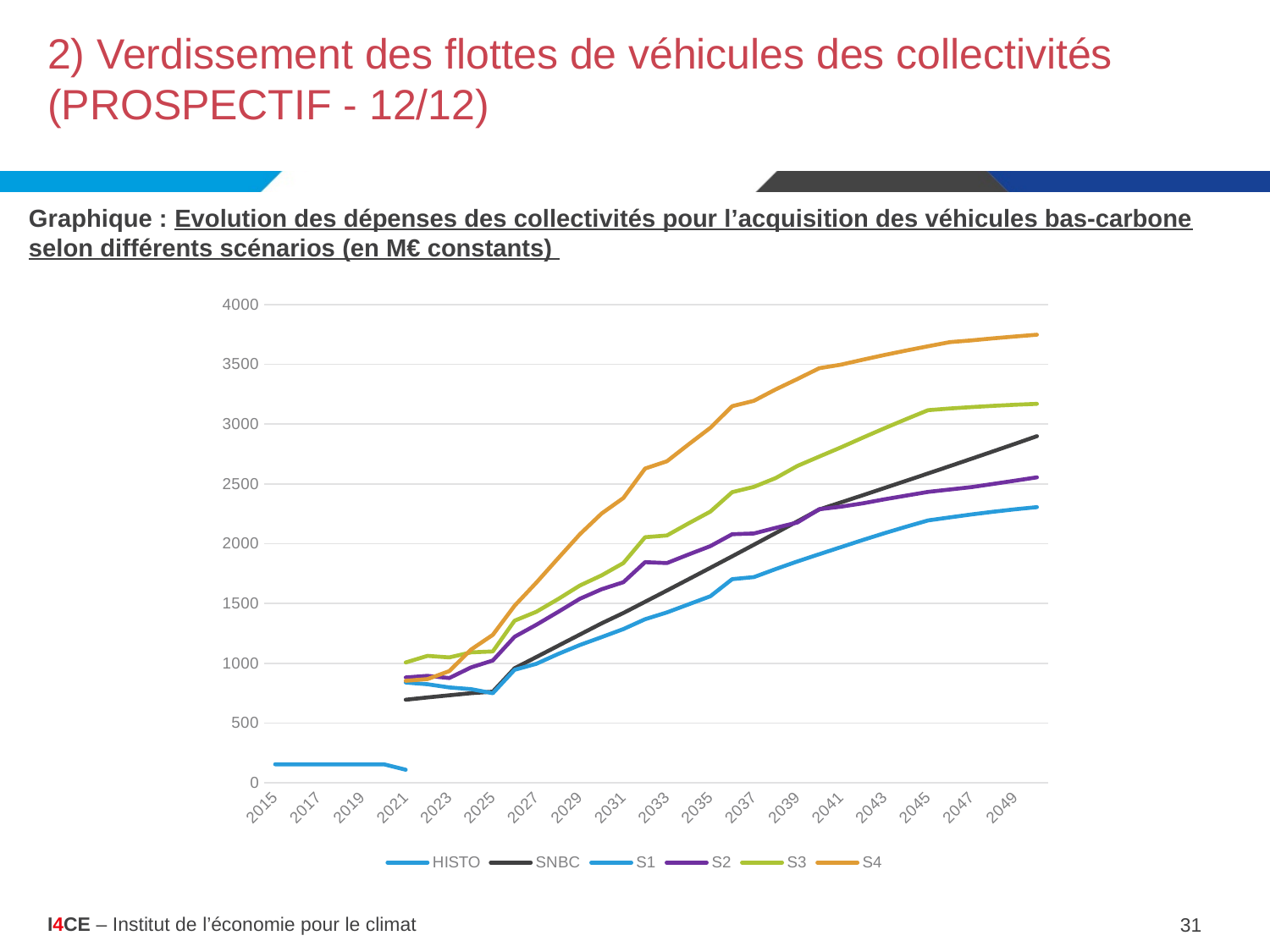
Is the value for S1 in 2049 greater or less than 2000? greater How many series does the legend list? 6 Among the scenario series S1, S2, S3 and S4, which has the lowest value in 2049? S1 Does the S4 series rise or fall between 2025 and 2049? rise What unit is given in the chart title for the expenditure values? M€ constants What kind of chart is shown on the slide? line chart Which series has the highest value in 2049? S4 Is the value for S4 in 2035 greater or less than 2500? greater Is the value for S3 in 2049 greater or less than 3000? greater In 2049, which is larger, the value for S3 or the value for S2? S3